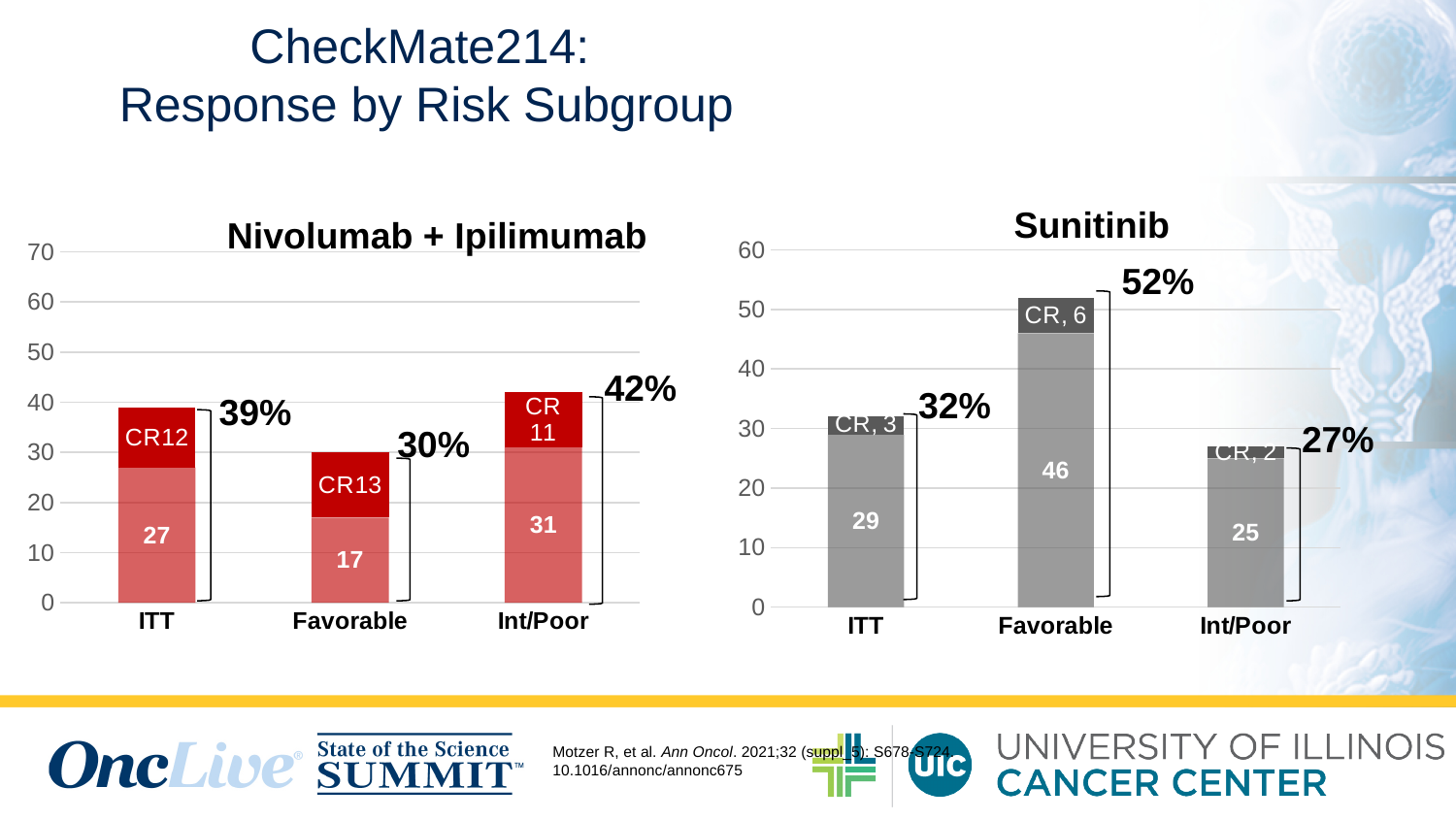
In the Sunitinib chart, what is the total of the Int/Poor bar (lower segment plus CR)? 27 In the Sunitinib chart, what is the value of the lower (non-CR) segment of the ITT bar? 29 In the Nivolumab + Ipilimumab chart, what is the total response rate shown for the Int/Poor group? 42% In the Nivolumab + Ipilimumab chart, which group has the lowest total response rate? Favorable In the Nivolumab + Ipilimumab chart, what is the CR value labelled on the Favorable bar? 13 In the Sunitinib chart, what is the total response rate shown for the Favorable group? 52% In the Nivolumab + Ipilimumab chart, what is the difference between the CR values for ITT and Int/Poor? 1 How many groups are shown on the x axis of the Sunitinib chart? 3 In the Sunitinib chart, what is the difference between the total response rates for Favorable and Int/Poor? 25% In the Sunitinib chart, which group has the highest total response rate? Favorable What type of chart is the Nivolumab + Ipilimumab chart? Stacked bar chart Which is larger: the total response rate for ITT in the Nivolumab + Ipilimumab chart or for ITT in the Sunitinib chart? Nivolumab + Ipilimumab